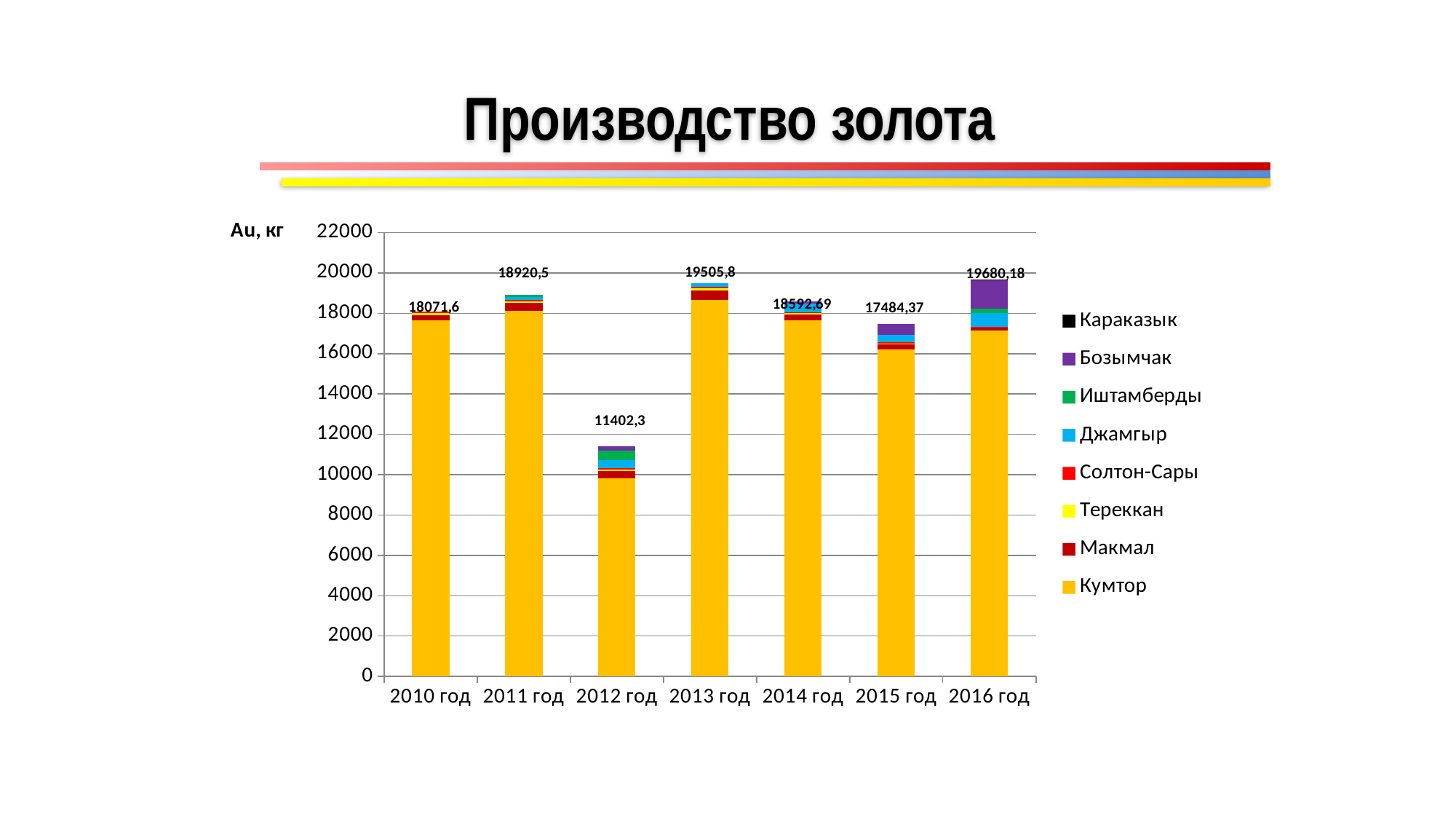
What is the total gold production shown for 2012 год? 11402,3 What is the difference between the total for 2013 год and the total for 2012 год? 8103,5 How many years are shown on the x axis? 7 What kind of chart is shown on the slide? stacked bar chart Which total is larger, 2014 год or 2015 год? 2014 год How many series does the legend list? 8 Which year has the lowest total gold production? 2012 год What is the label on the vertical axis of the chart? Au, кг What is the total value labelled on the bar for 2010 год? 18071,6 What is the total value labelled on the bar for 2016 год? 19680,18 Which year has the highest total gold production? 2016 год Is the Кумтор value for 2016 год greater or less than 16000? greater